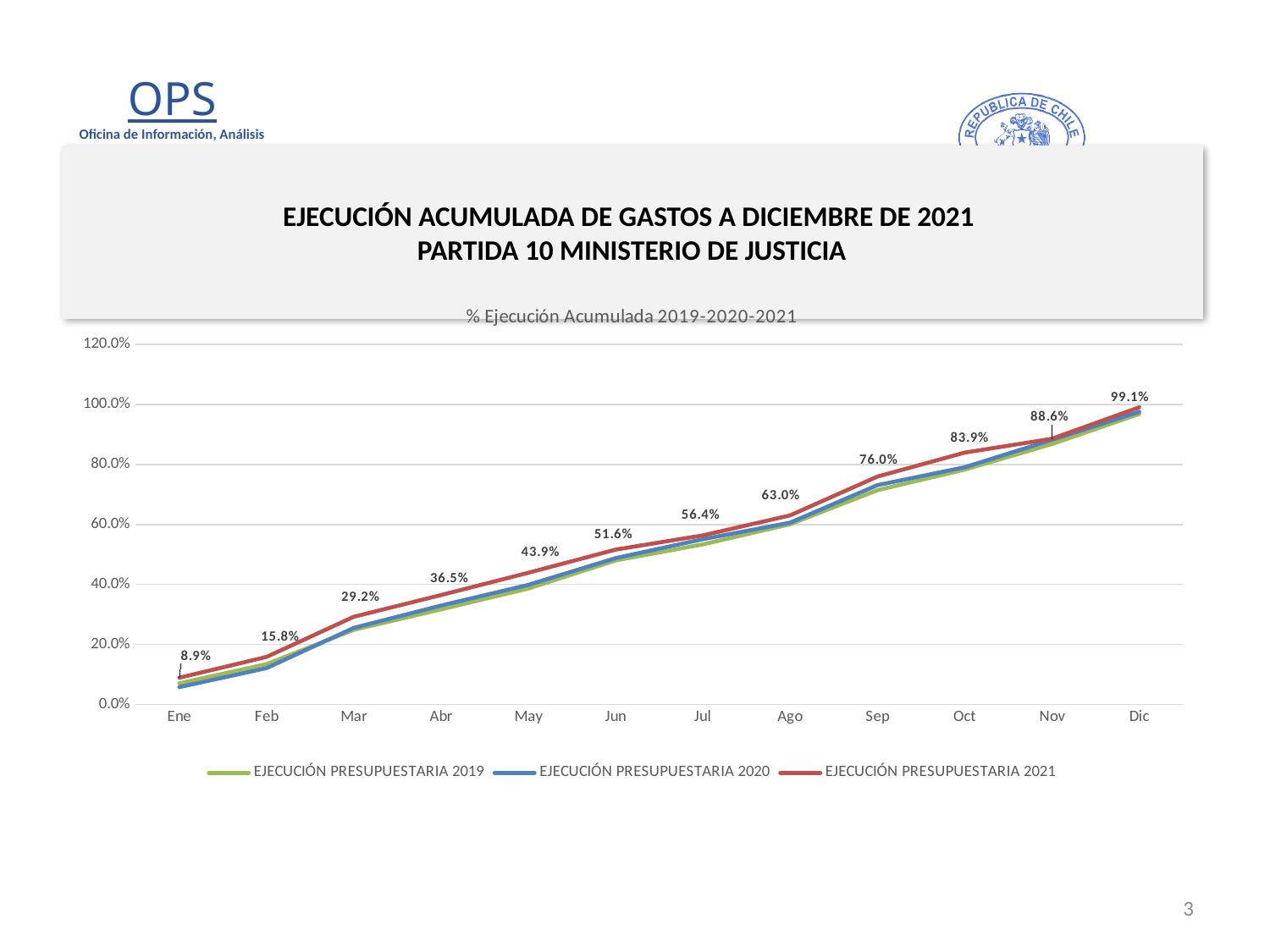
How many months are plotted along the x axis? 12 What is the value for EJECUCIÓN PRESUPUESTARIA 2021 in Sep? 76.0% In which month is the EJECUCIÓN PRESUPUESTARIA 2021 value highest? Dic What type of chart is shown on the slide? Line chart What is the title of the chart? % Ejecución Acumulada 2019-2020-2021 How many series does the legend list? 3 What is the value for EJECUCIÓN PRESUPUESTARIA 2021 in Dic? 99.1% In which month is the EJECUCIÓN PRESUPUESTARIA 2021 value lowest? Ene Do the EJECUCIÓN PRESUPUESTARIA 2021 values rise or fall from Ene to Dic? Rise What is the value for EJECUCIÓN PRESUPUESTARIA 2021 in Jun? 51.6% What is the difference between the EJECUCIÓN PRESUPUESTARIA 2021 values for Dic and Nov? 10.5% What is the value for EJECUCIÓN PRESUPUESTARIA 2021 in Ene? 8.9%